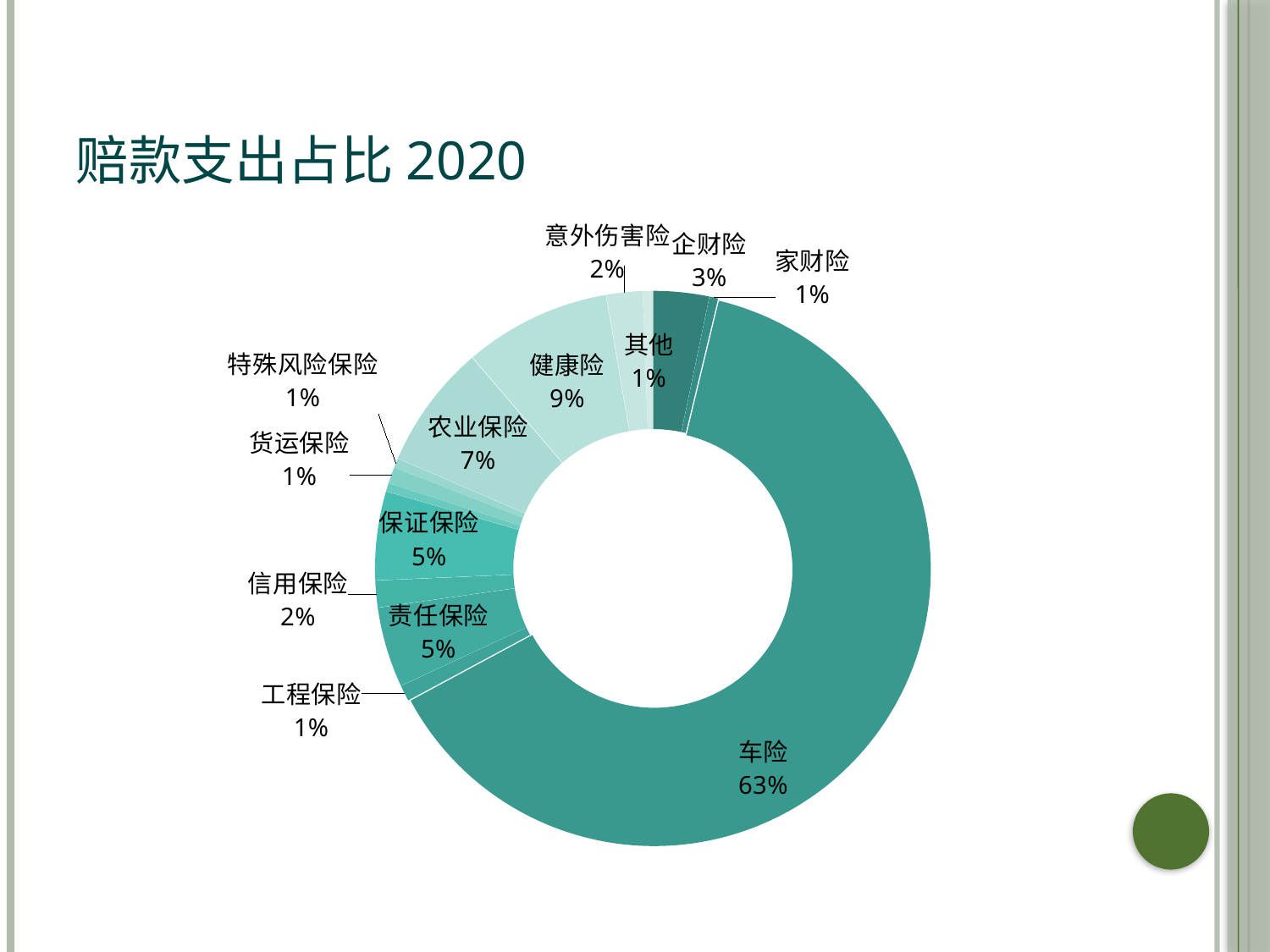
What is the combined share of 责任保险 and 保证保险? 10% Which category has the largest share of the chart? 车险 What is the difference between the shares of 健康险 and 农业保险? 2% What is the value shown for 健康险? 9% What share of the chart does 车险 account for? 63% What kind of chart is shown on the slide? doughnut (pie) chart What is the value shown for 企财险? 3% Which is larger, the share of 保证保险 or the share of 意外伤害险? 保证保险 What is the value shown for 农业保险? 7% What is the value shown for 信用保险? 2% What is the title of the chart on the slide? 赔款支出占比 2020